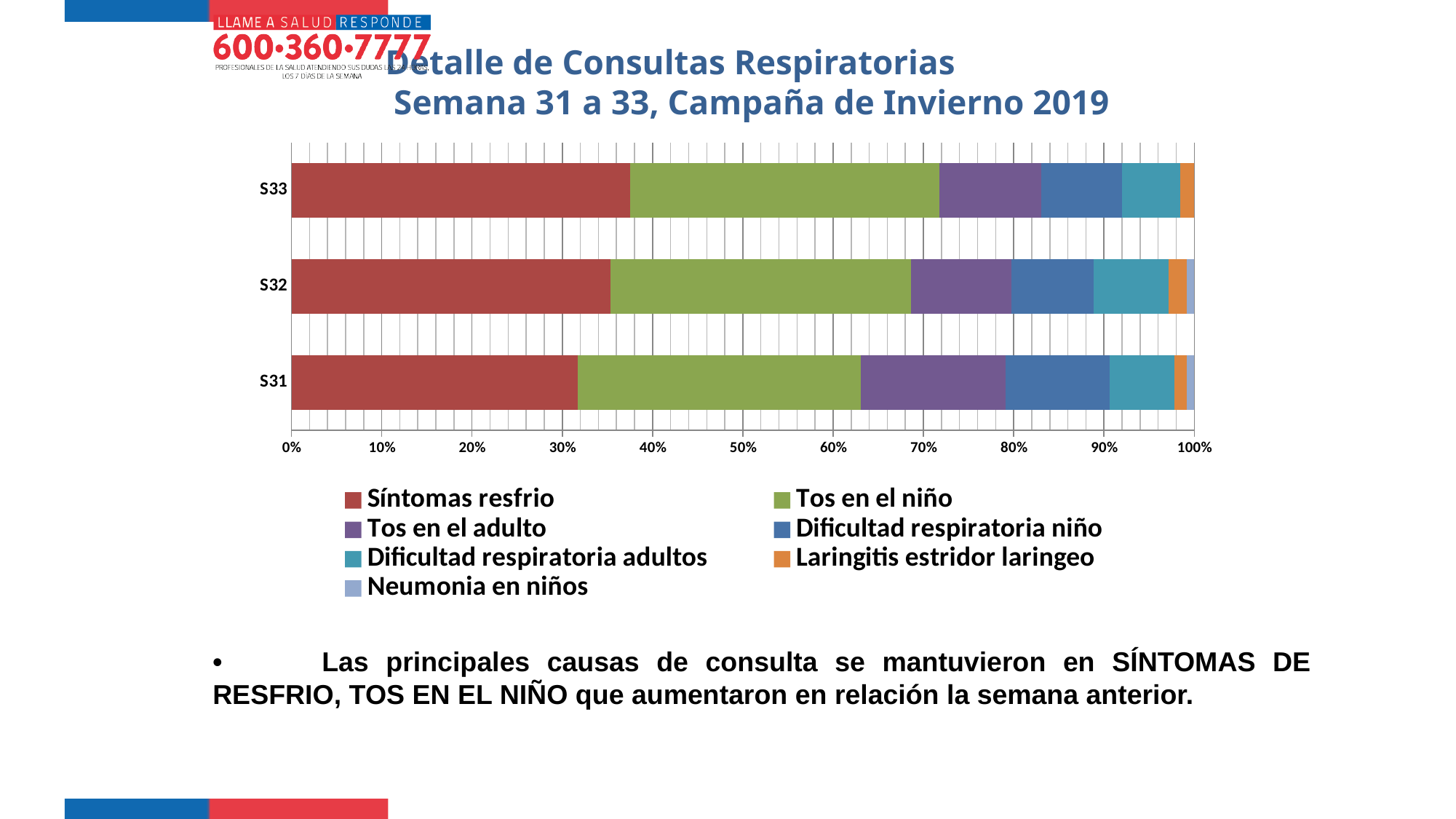
How many weeks (categories) are plotted on the chart? 3 Which series is shown as the leftmost (first) segment of each bar? Síntomas resfrio Is the share of Síntomas resfrio in S33 greater or less than 30%? greater What is the highest value shown on the horizontal axis? 100% Is the share of Síntomas resfrio in S31 greater or less than 40%? less Which week has the larger share of Tos en el adulto, S31 or S33? S31 Is the share of Tos en el adulto in S31 greater or less than 20%? less What kind of chart is shown on the slide? Stacked bar chart How many series does the legend list? 7 Which week has the larger share of Síntomas resfrio, S31 or S33? S33 Does the share of Síntomas resfrio rise or fall from S31 to S33? rise What colour represents Tos en el niño in the chart? Green